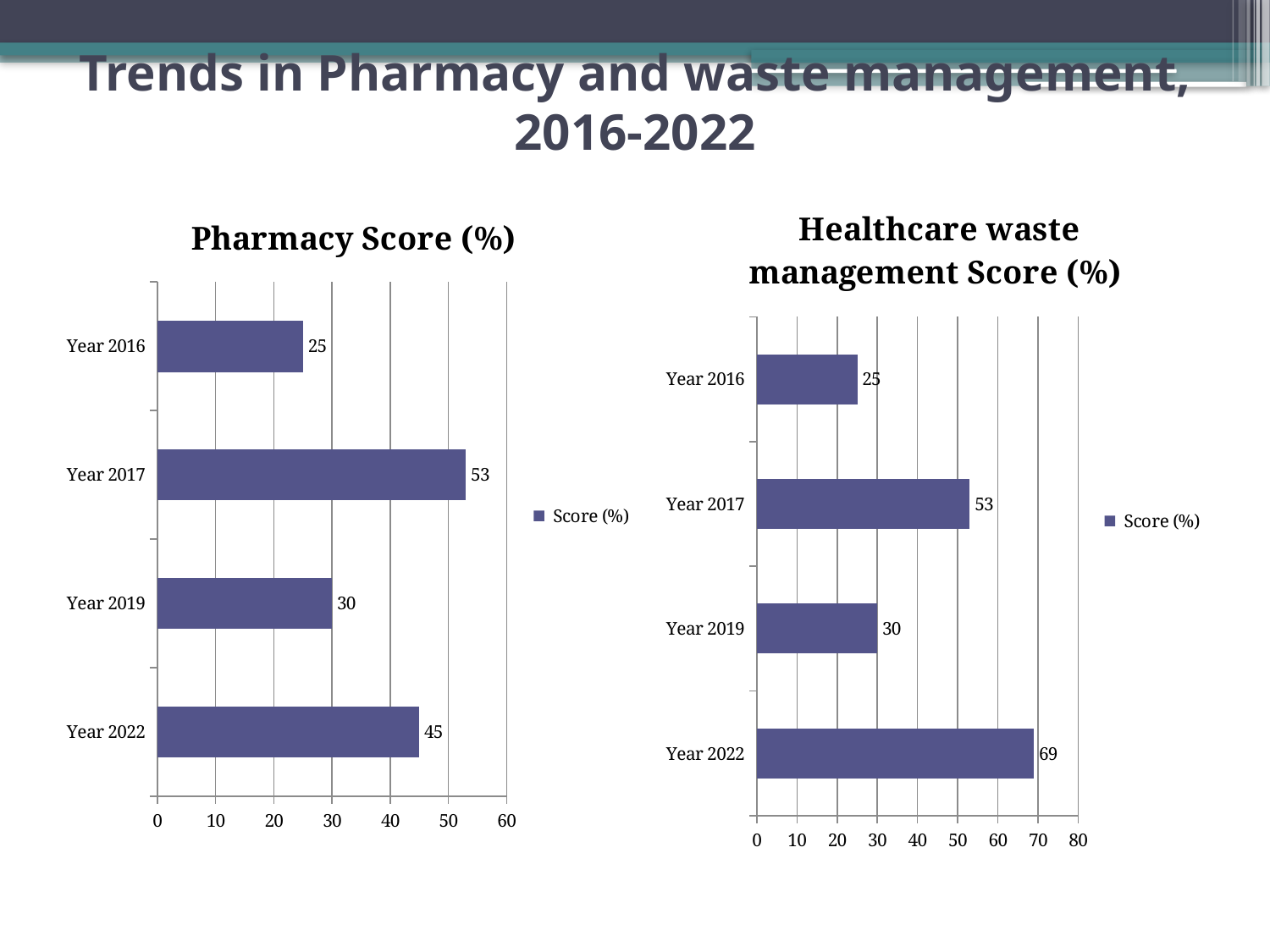
In the Pharmacy Score (%) chart, what is the value for Year 2017? 53 In the Healthcare waste management Score (%) chart, what is the value for Year 2022? 69 How many years are shown in the Healthcare waste management Score (%) chart? 4 In the Pharmacy Score (%) chart, which year has the highest score? Year 2017 In the Pharmacy Score (%) chart, what is the difference between the Year 2017 and Year 2022 values? 8 In the Pharmacy Score (%) chart, which year has the lowest score? Year 2016 In the Healthcare waste management Score (%) chart, what is the difference between the Year 2022 and Year 2019 values? 39 What type of chart is the Pharmacy Score (%) chart? Bar chart In the Pharmacy Score (%) chart, which is larger, the value for Year 2019 or Year 2022? Year 2022 In the Pharmacy Score (%) chart, what is the value for Year 2022? 45 In the Healthcare waste management Score (%) chart, which year has the highest score? Year 2022 What is the legend entry shown for the Healthcare waste management Score (%) chart? Score (%)